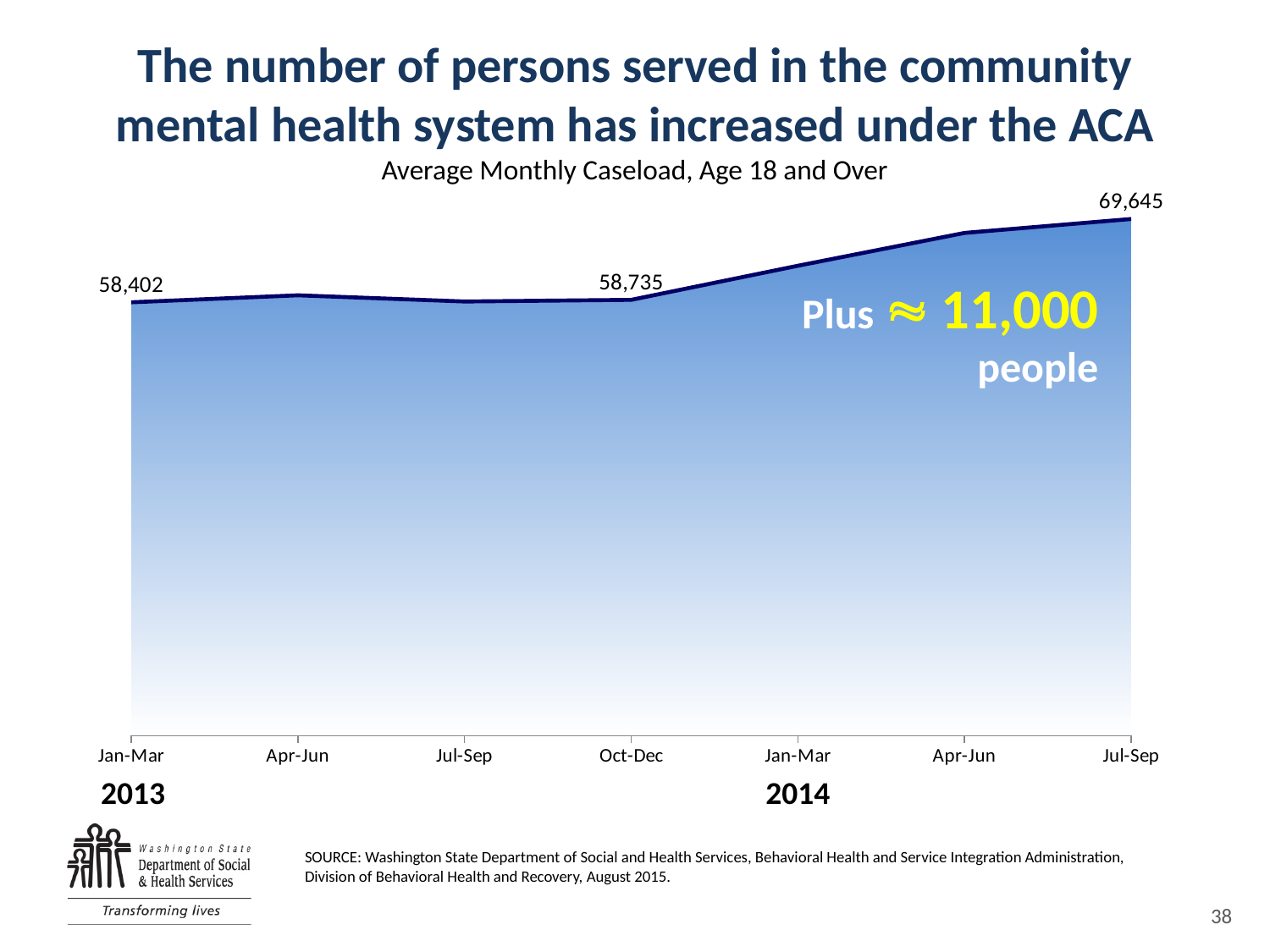
What is the difference between the caseload in Jul-Sep 2014 and Oct-Dec 2013? 10,910 Does the caseload rise or fall from Oct-Dec 2013 to Jul-Sep 2014? Rise Which quarter has the highest average monthly caseload? Jul-Sep 2014 What is the difference between the caseload in Jul-Sep 2014 and Jan-Mar 2013? 11,243 What is the average monthly caseload for Oct-Dec 2013? 58,735 What is the difference between the caseload in Oct-Dec 2013 and Jan-Mar 2013? 333 What is the average monthly caseload for Jan-Mar 2013? 58,402 What is the average monthly caseload for Jul-Sep 2014? 69,645 What is the subtitle of the chart? Average Monthly Caseload, Age 18 and Over Which is larger, the caseload in Jul-Sep 2014 or in Oct-Dec 2013? Jul-Sep 2014 How many quarters are plotted on the chart? 7 What kind of chart is shown on the slide? Area chart